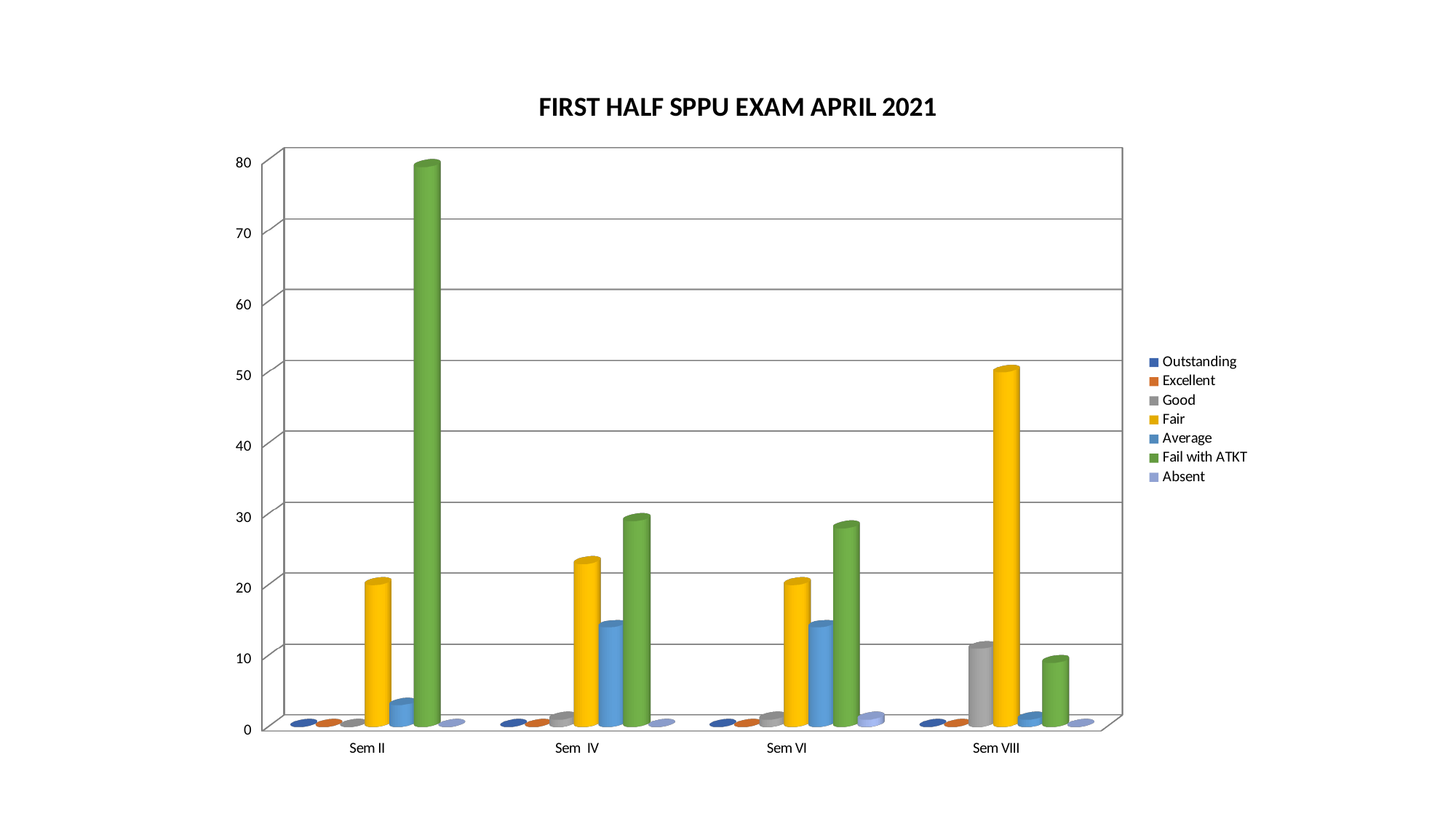
What is the title of the chart? FIRST HALF SPPU EXAM APRIL 2021 Which semester has the lowest Fail with ATKT value? Sem VIII Is the Fail with ATKT value for Sem II greater or less than 70? greater How many semester categories are shown on the x axis? 4 In Sem VIII, which is larger: the Fair value or the Fail with ATKT value? Fair Which semester has the highest Fail with ATKT value? Sem II Which semester has the highest Fair value? Sem VIII Is the Fair value for Sem IV greater or less than 20? greater What kind of chart is shown on the slide? Bar chart How many series does the legend list? 7 Which series is shown in green in the legend? Fail with ATKT